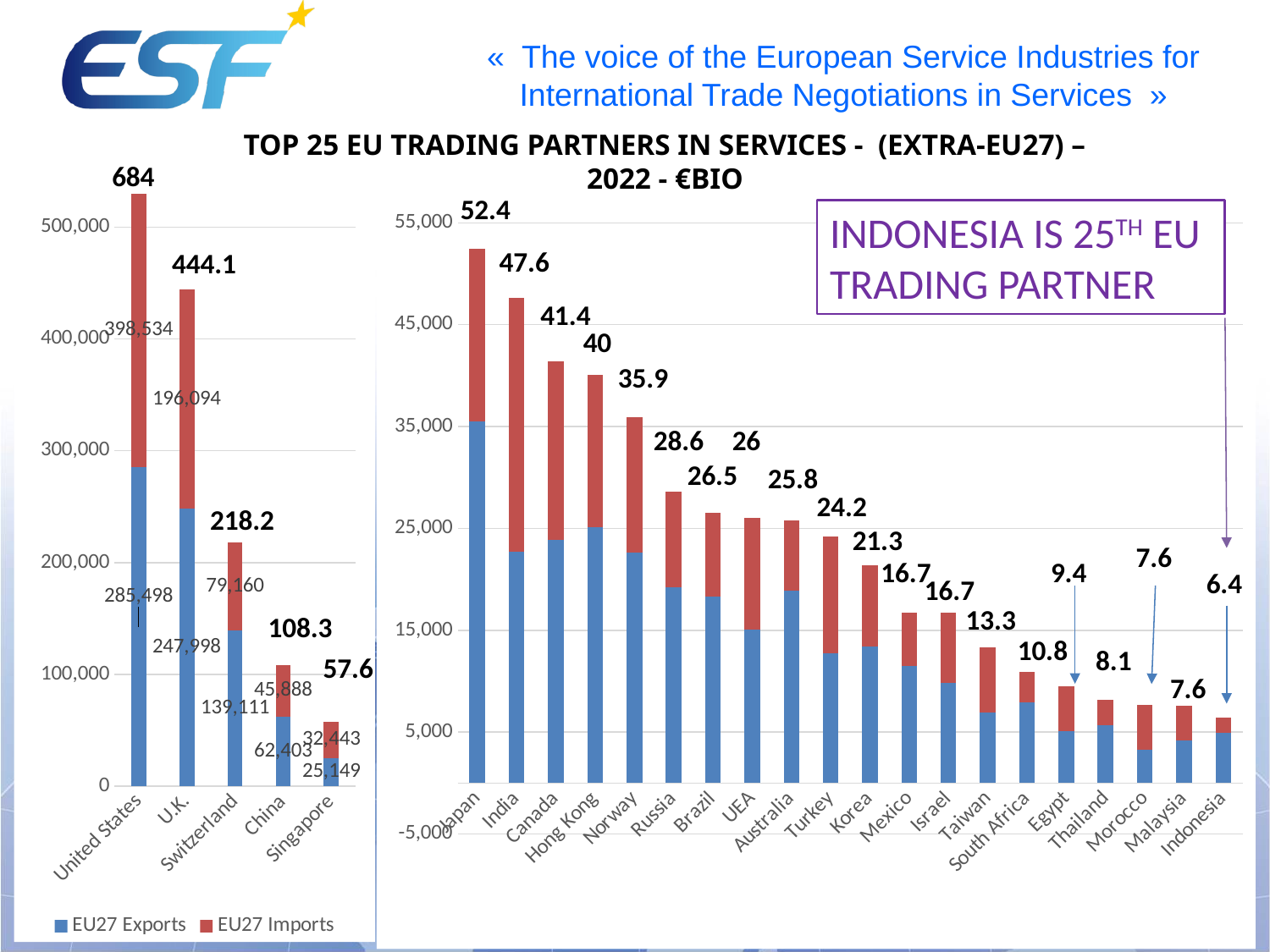
On the left chart, what is the total value labelled for the United States? 684 On the right chart, what is the value labelled for Japan? 52.4 On the left chart, what is the total value labelled for Switzerland? 218.2 What kind of chart is the right chart? Stacked bar chart On the right chart, how many countries are shown on the x axis? 20 On the left chart, what is the difference between the total labels for the U.K. and China? 335.8 On the right chart, what is the difference between the values for India and Hong Kong? 7.6 On the right chart, which is larger, the value for Canada or the value for Norway? Canada On the left chart, which country has the lowest total value? Singapore On the right chart, which country has the lowest value? Indonesia On the right chart, what is the value labelled for Turkey? 24.2 On the left chart, how many series does the legend list? 2